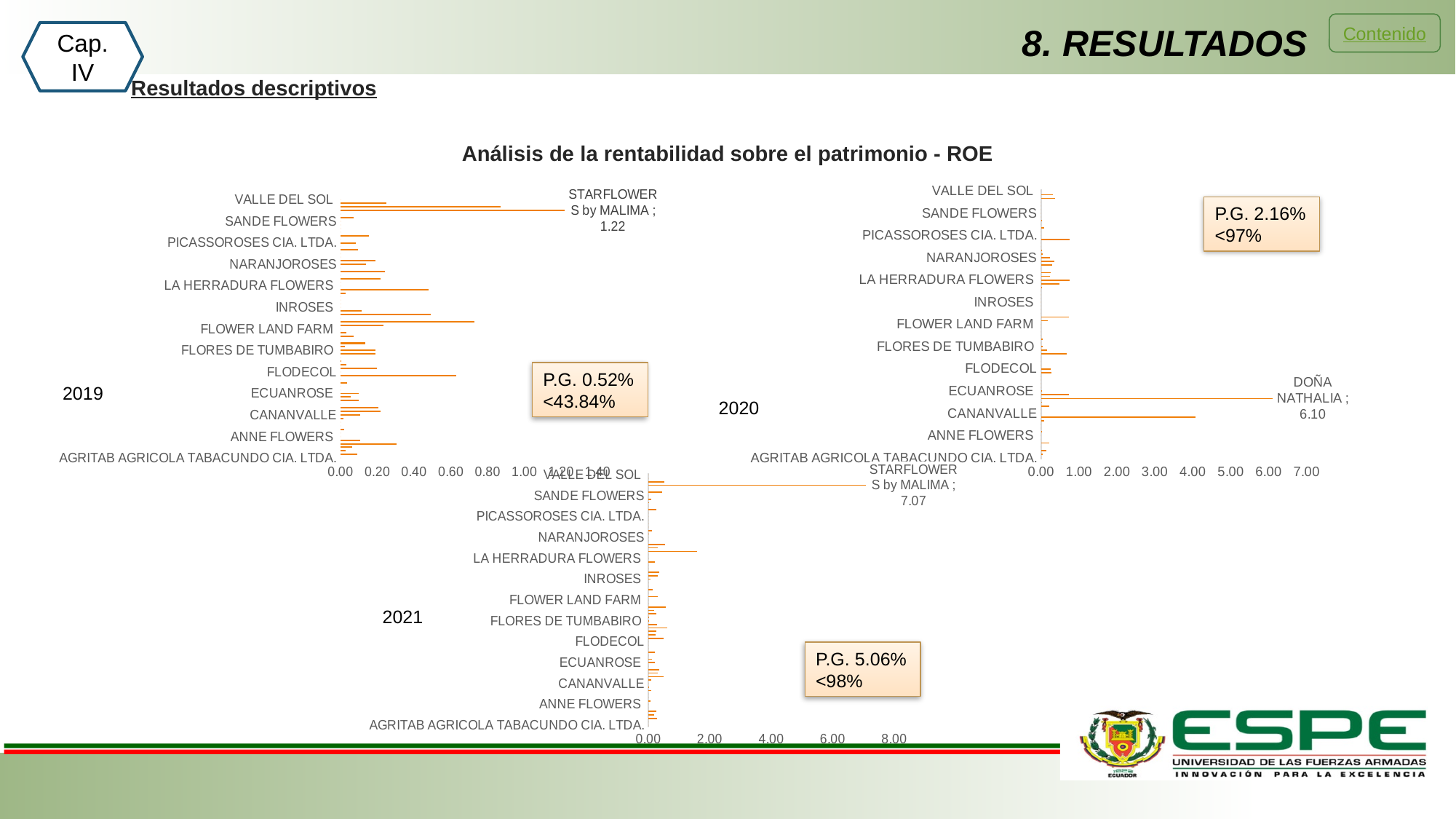
What is the difference between the labelled value for STARFLOWERS by MALIMA in the 2021 chart and in the 2019 chart? 5.85 In the 2020 chart, what value is labelled for DOÑA NATHALIA? 6.10 Which is larger: the labelled value for STARFLOWERS by MALIMA in the 2021 chart or the labelled value for DOÑA NATHALIA in the 2020 chart? STARFLOWERS by MALIMA in 2021 What is the overall title shown above the charts on the slide? Análisis de la rentabilidad sobre el patrimonio - ROE In the 2019 chart, what value is labelled for STARFLOWERS by MALIMA? 1.22 In the 2021 chart, which company has the longest bar? STARFLOWERS by MALIMA What is the highest tick value shown on the x axis of the 2021 chart? 8.00 In the 2020 chart, which company has the longest bar? DOÑA NATHALIA What kind of chart is the 2019 chart? bar chart In the 2020 chart, is the value for DOÑA NATHALIA greater or less than 5.00? greater How many charts are shown on the slide? 3 In the 2021 chart, what value is labelled for STARFLOWERS by MALIMA? 7.07